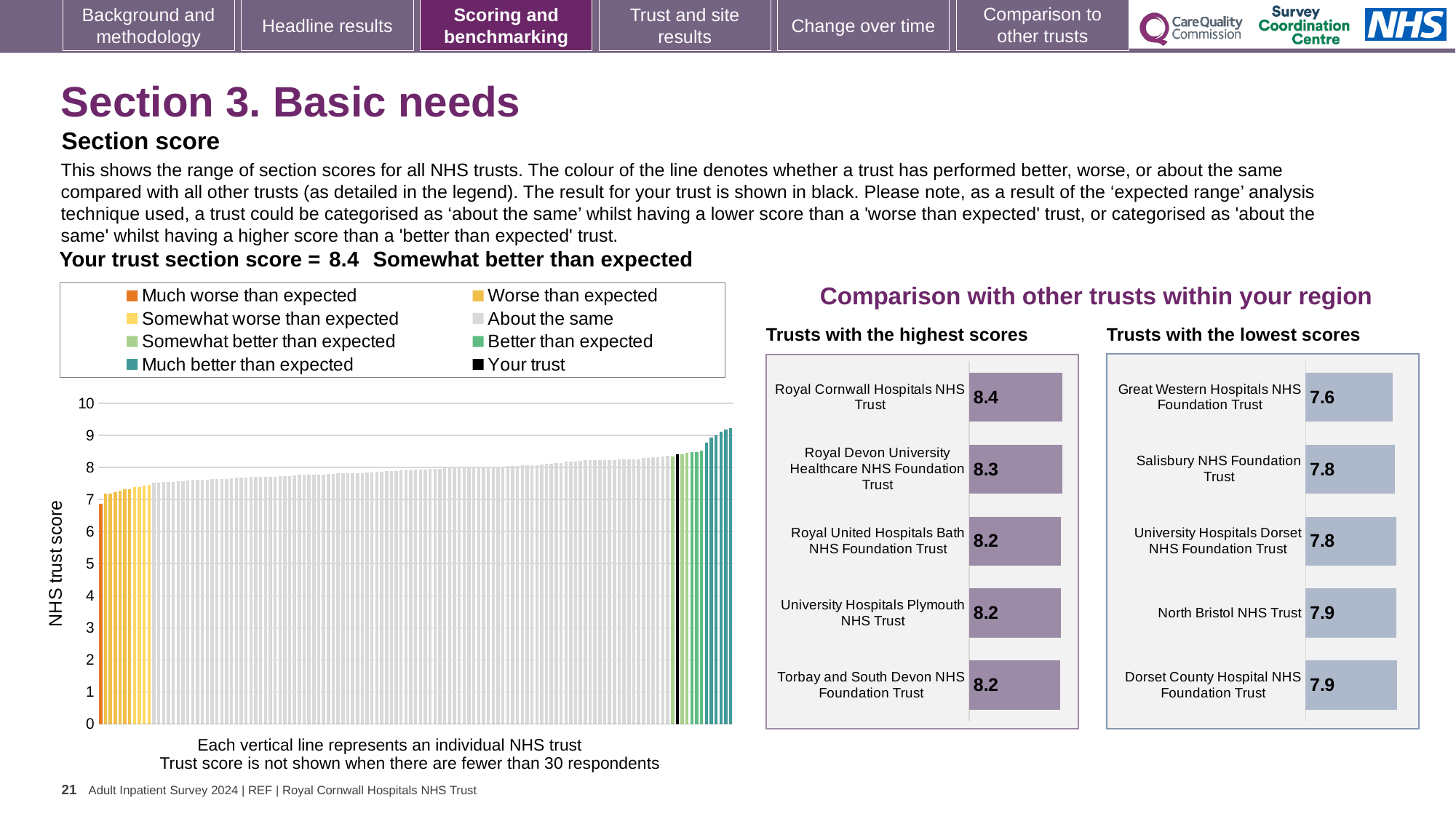
Which is larger: the score for Royal Devon University Healthcare NHS Foundation Trust in the highest scores chart, or the score for Salisbury NHS Foundation Trust in the lowest scores chart? Royal Devon University Healthcare NHS Foundation Trust In the 'Trusts with the lowest scores' chart, which trust has the lowest score? Great Western Hospitals NHS Foundation Trust In the 'Trusts with the highest scores' chart, what is the score for Royal Cornwall Hospitals NHS Trust? 8.4 In the 'Trusts with the lowest scores' chart, what is the difference between the scores of Dorset County Hospital NHS Foundation Trust and Great Western Hospitals NHS Foundation Trust? 0.3 In the 'Trusts with the lowest scores' chart, what is the score for Great Western Hospitals NHS Foundation Trust? 7.6 In the main 'NHS trust score' chart on the left, do the values rise or fall from left to right? Rise In the 'Trusts with the highest scores' chart, what is the difference between the scores of Royal Cornwall Hospitals NHS Trust and Torbay and South Devon NHS Foundation Trust? 0.2 How many entries does the legend of the main 'NHS trust score' chart list? 8 In the 'Trusts with the lowest scores' chart, what is the score for North Bristol NHS Trust? 7.9 In the 'Trusts with the highest scores' chart, which trust has the highest score? Royal Cornwall Hospitals NHS Trust How many trusts are shown in the 'Trusts with the lowest scores' chart? 5 In the 'Trusts with the highest scores' chart, what is the score for Royal Devon University Healthcare NHS Foundation Trust? 8.3